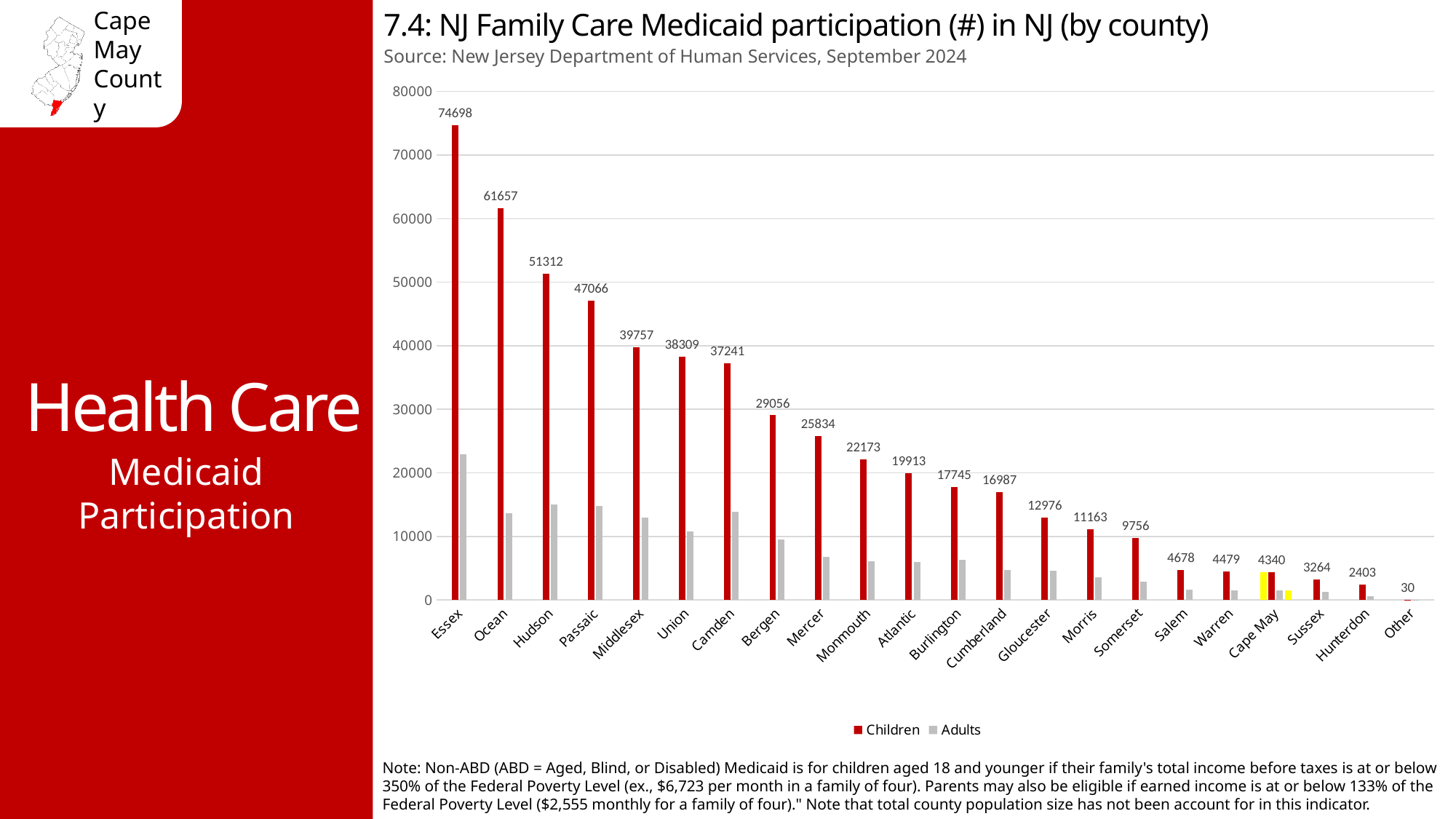
How many series does the legend list? 2 What is the Children value for Essex? 74698 Is the Adults value for Essex greater or less than 20000? greater Is the Adults value for Ocean greater or less than 20000? less What is the Children value for Cape May? 4340 Which county has the highest Children value? Essex How many categories are shown on the x axis? 22 What kind of chart is shown? Bar chart What is the Children value for Hudson? 51312 Which category has the lowest Children value? Other Which has a larger Children value, Bergen or Mercer? Bergen What is the difference between the Children values for Essex and Ocean? 13041